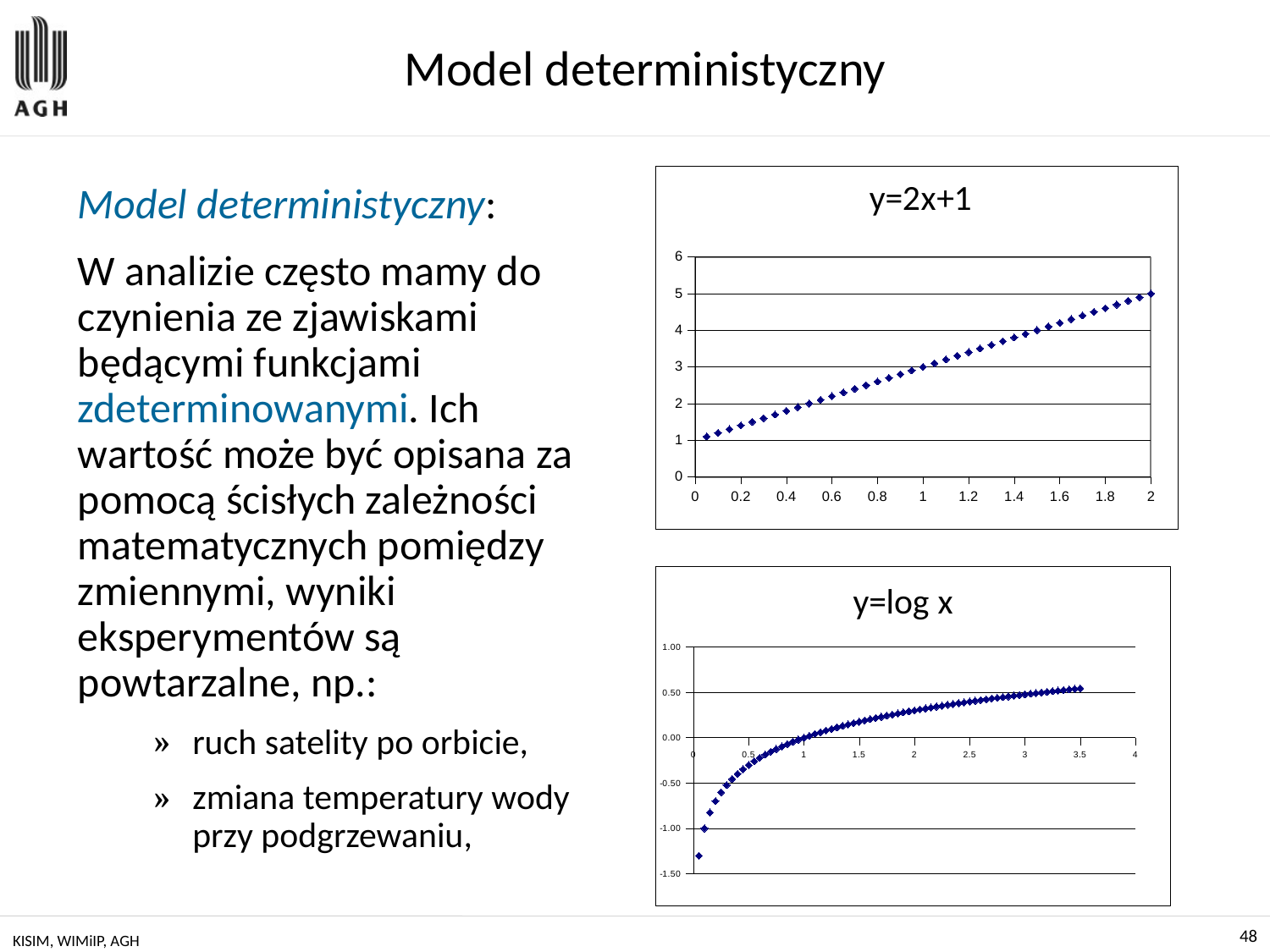
What kind of chart is the chart titled "y=log x"? scatter chart What kind of chart is the chart titled "y=2x+1"? scatter chart In the chart titled "y=2x+1", what is the y value of the point at x = 2? 5 In the chart titled "y=2x+1", what is the y value of the point at x = 1? 3 In the chart titled "y=log x", do the values rise or fall as x increases? rise In the chart titled "y=log x", what is the y value of the point at x = 1? 0.00 In the chart titled "y=log x", is the y value at x = 0.5 greater or less than -0.50? greater What is the title of the lower chart on the slide? y=log x In the chart titled "y=log x", is the y value at x = 2 greater or less than 0.50? less In the chart titled "y=2x+1", do the values rise or fall as x increases? rise In the chart titled "y=2x+1", is the y value at x = 1.6 greater or less than 4? greater